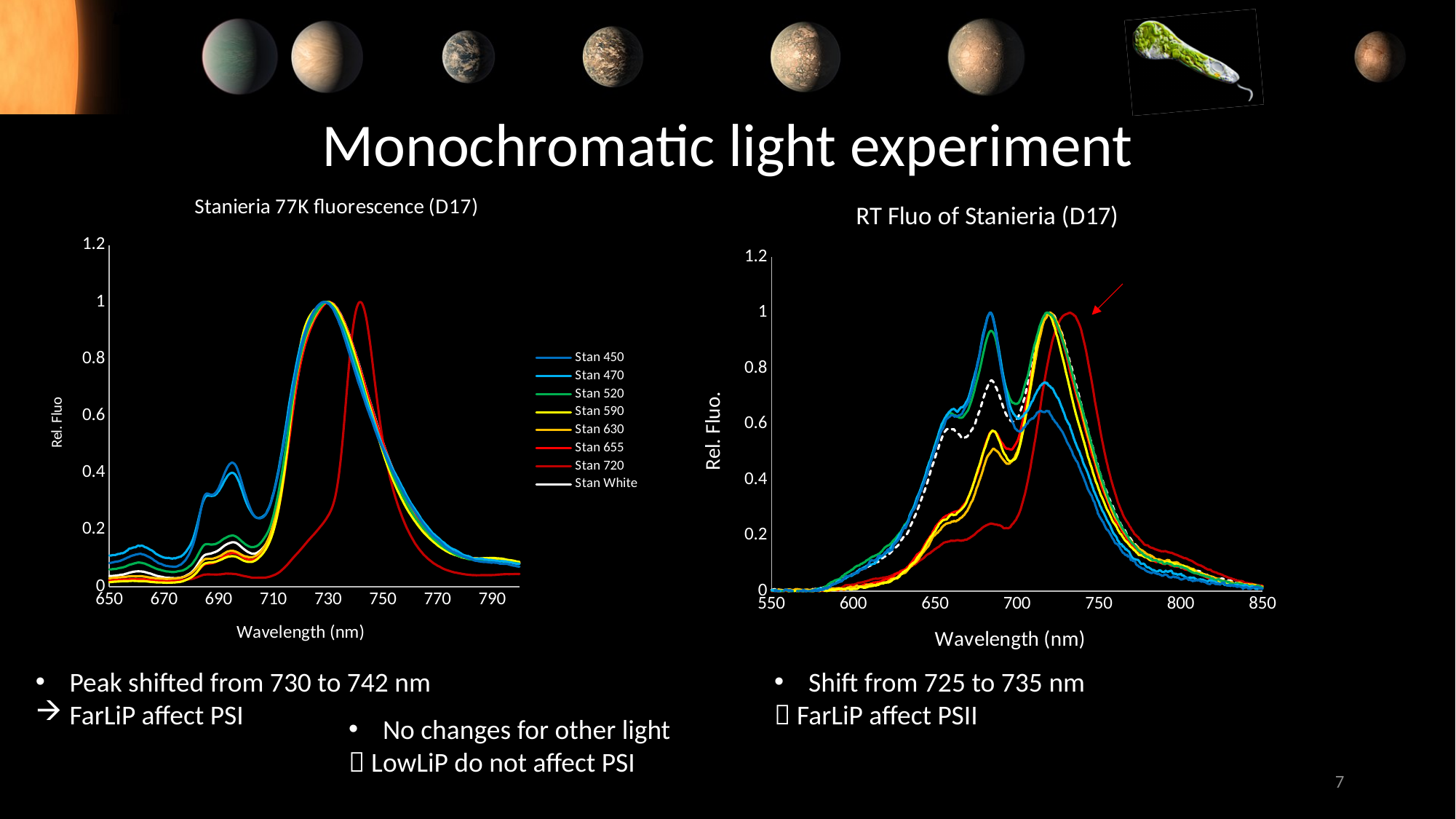
What is the title of the chart on the right side of the slide? RT Fluo of Stanieria (D17) How many series does the legend of the 'Stanieria 77K fluorescence (D17)' chart list? 8 In the 'RT Fluo of Stanieria (D17)' chart, do the curves rise or fall between 750 nm and 850 nm? fall What is the x-axis label of the 'RT Fluo of Stanieria (D17)' chart? Wavelength (nm) What kind of chart is the 'Stanieria 77K fluorescence (D17)' chart? line chart In the 'RT Fluo of Stanieria (D17)' chart, is the value of the red line at 700 nm greater or less than 0.4? less In the 'Stanieria 77K fluorescence (D17)' chart, is the value of Stan 450 at 695 nm greater or less than 0.2? greater In the 'Stanieria 77K fluorescence (D17)' chart, what is the highest value shown on the y axis? 1.2 In the 'Stanieria 77K fluorescence (D17)' chart, is the value of Stan 655 at 690 nm greater or less than 0.2? less What is the lowest wavelength tick shown on the x axis of the 'RT Fluo of Stanieria (D17)' chart? 550